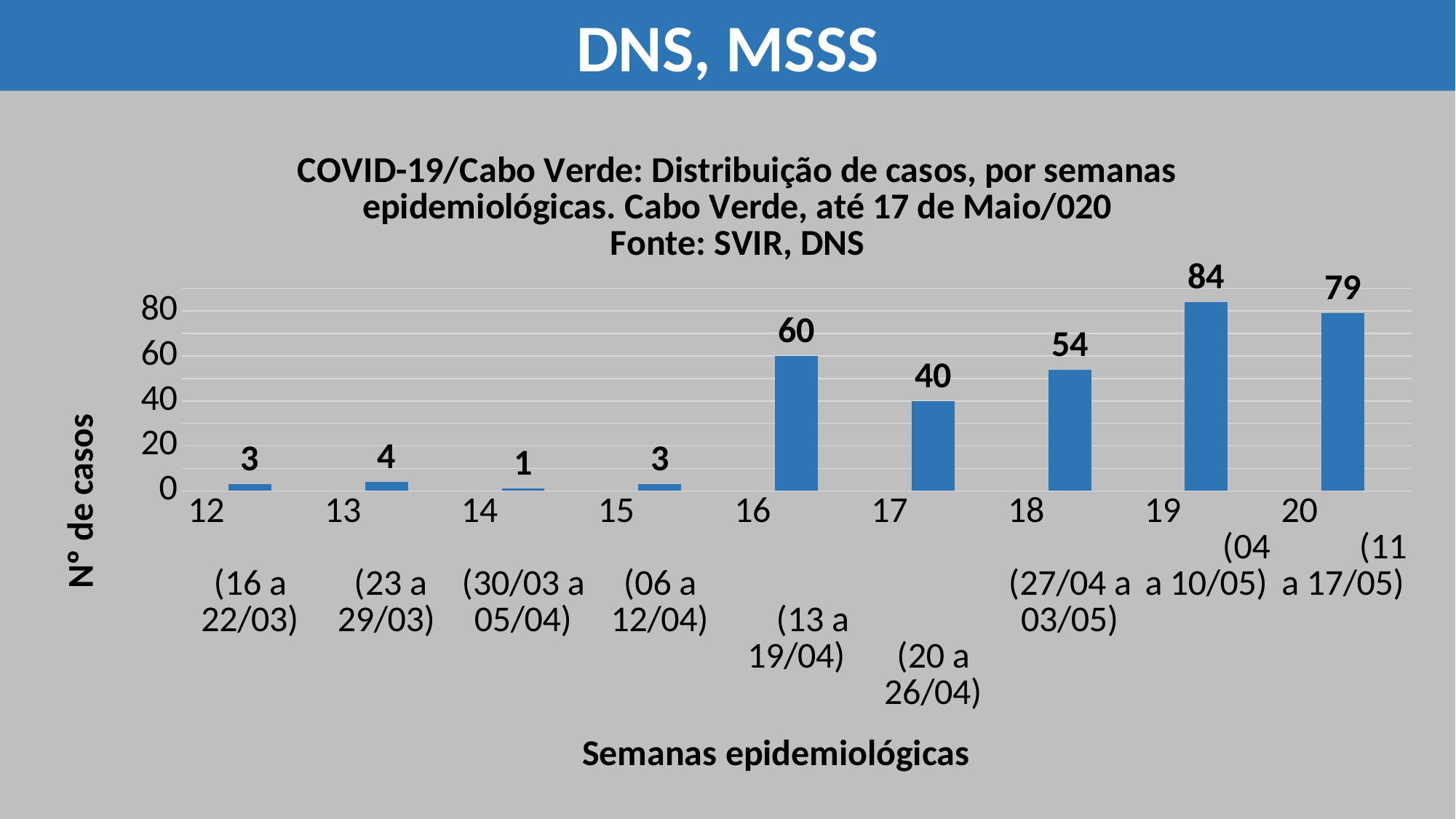
What type of chart is shown on the slide? Bar chart What is the label of the y axis? N° de casos Do the number of cases generally rise or fall from week 12 to week 19? Rise What is the difference in cases between week 16 and week 17? 20 Which epidemiological week has the lowest number of cases? 14 Which epidemiological week has the highest number of cases? 19 What is the number of cases for epidemiological week 19 (04 a 10/05)? 84 What is the difference in cases between week 19 and week 20? 5 What is the number of cases for epidemiological week 14 (30/03 a 05/04)? 1 Which has more cases, week 18 or week 17? Week 18 How many cases are shown for epidemiological week 16 (13 a 19/04)? 60 How many epidemiological weeks are plotted on the chart? 9